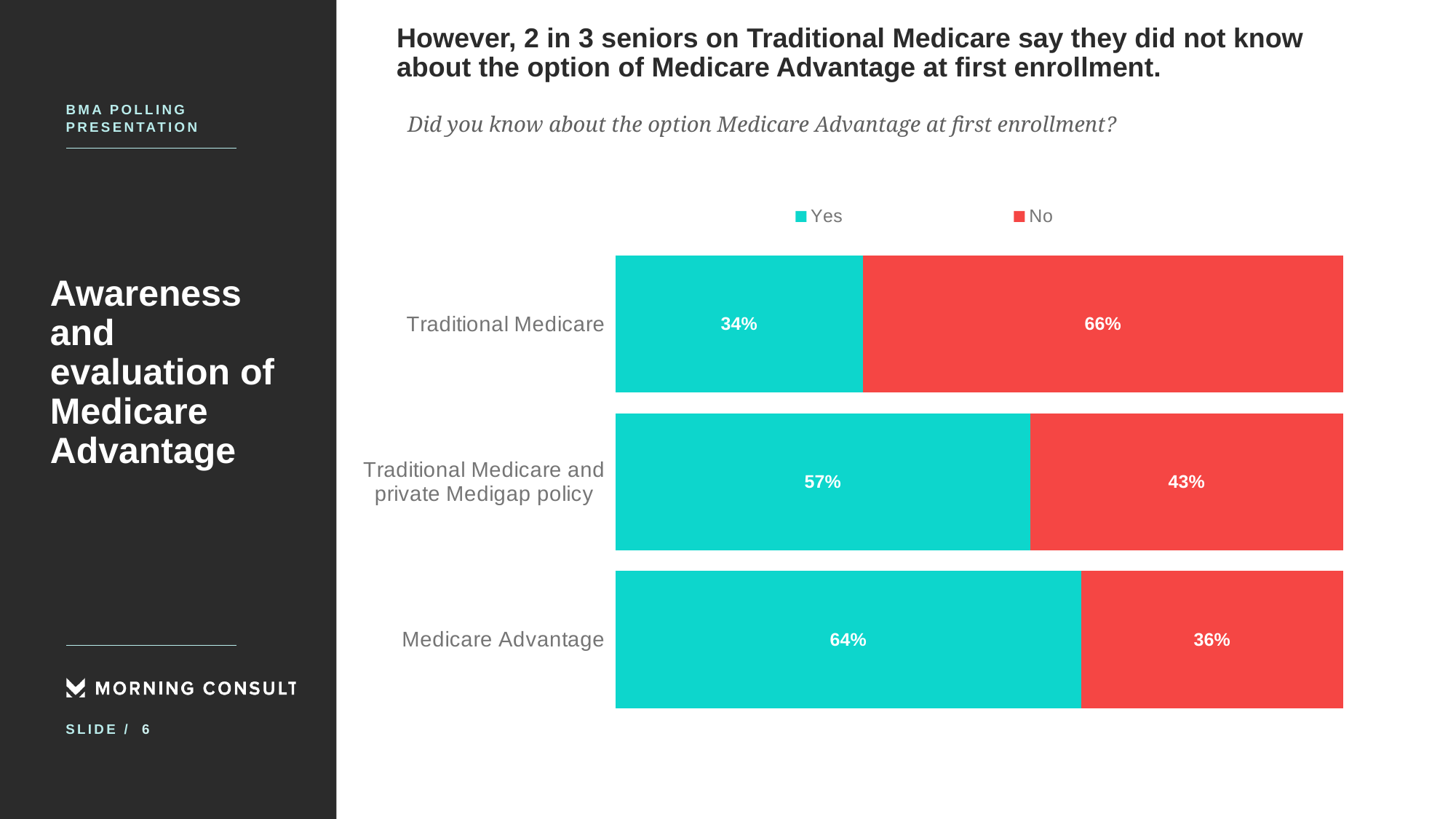
What is the difference between the No values for Traditional Medicare and Medicare Advantage? 30% What kind of chart is shown on the slide? Stacked bar chart How many series does the legend list? 2 Which category has the highest Yes value? Medicare Advantage Which category has the lowest Yes value? Traditional Medicare What percentage of Traditional Medicare respondents answered Yes? 34% How many categories are shown on the chart? 3 What is the No value for Medicare Advantage? 36% What is the total of the Yes and No values for Traditional Medicare and private Medigap policy? 100% What percentage of Traditional Medicare respondents answered No? 66% What is the Yes value for Traditional Medicare and private Medigap policy? 57% Which is larger: the Yes value for Traditional Medicare and private Medigap policy or the Yes value for Medicare Advantage? Medicare Advantage